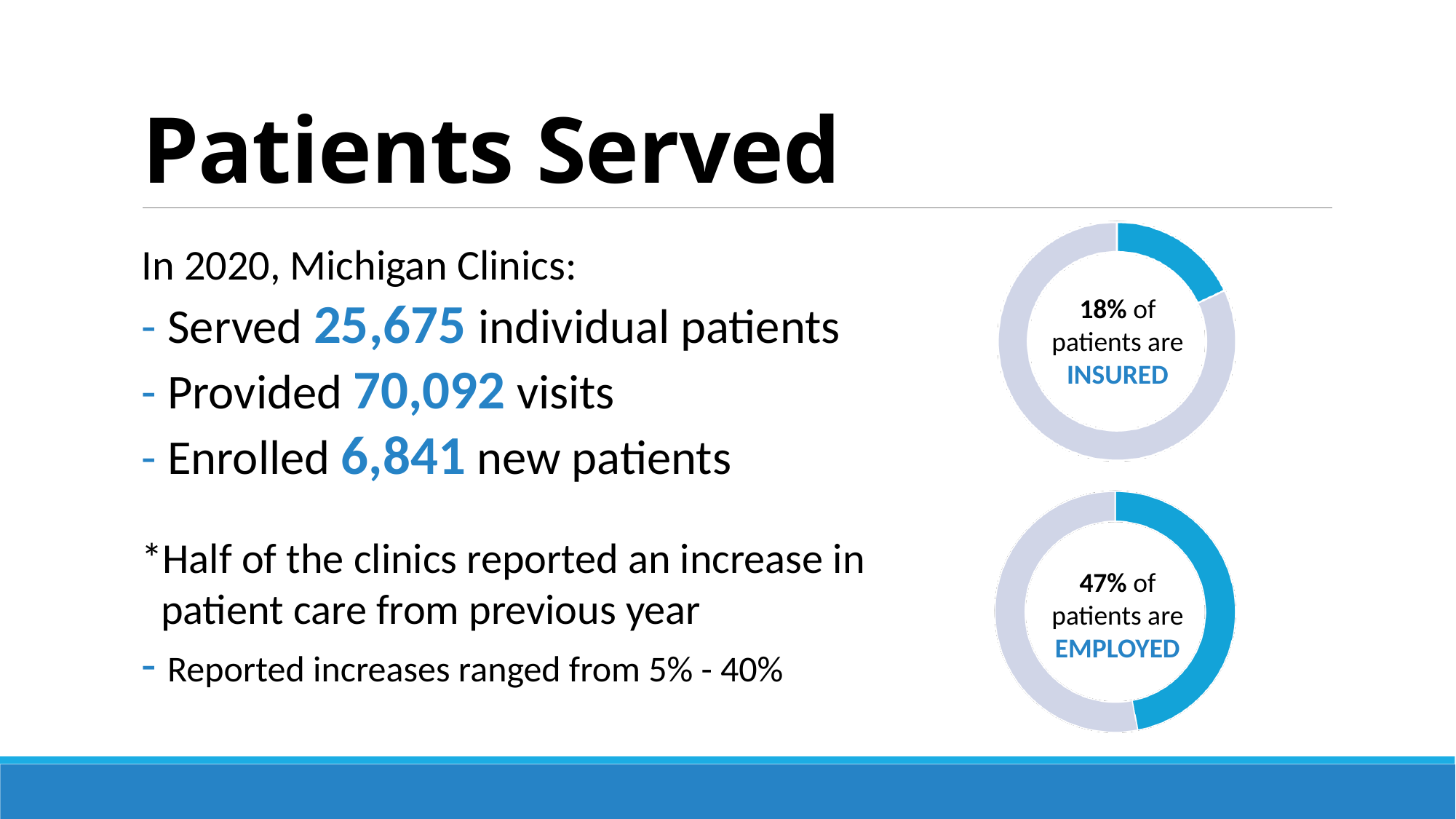
In the bottom donut chart, is the blue segment for employed patients more or less than half of the ring? Less What colour is used for the highlighted segment in both donut charts? Blue By how many percentage points does the share of employed patients exceed the share of insured patients? 29 percentage points In the top donut chart, what percentage of patients are insured? 18% How many donut charts are shown on the slide? 2 Which is larger: the share of patients who are insured or the share who are employed? Employed Which donut chart is positioned at the top of the slide: the insured chart or the employed chart? Insured In the bottom donut chart, what share of the ring is filled in blue? 47% In the bottom donut chart, what percentage of patients are employed? 47% In the top donut chart, what share of the ring is filled in blue? 18% What kind of chart is used to show the share of patients who are insured? Donut chart